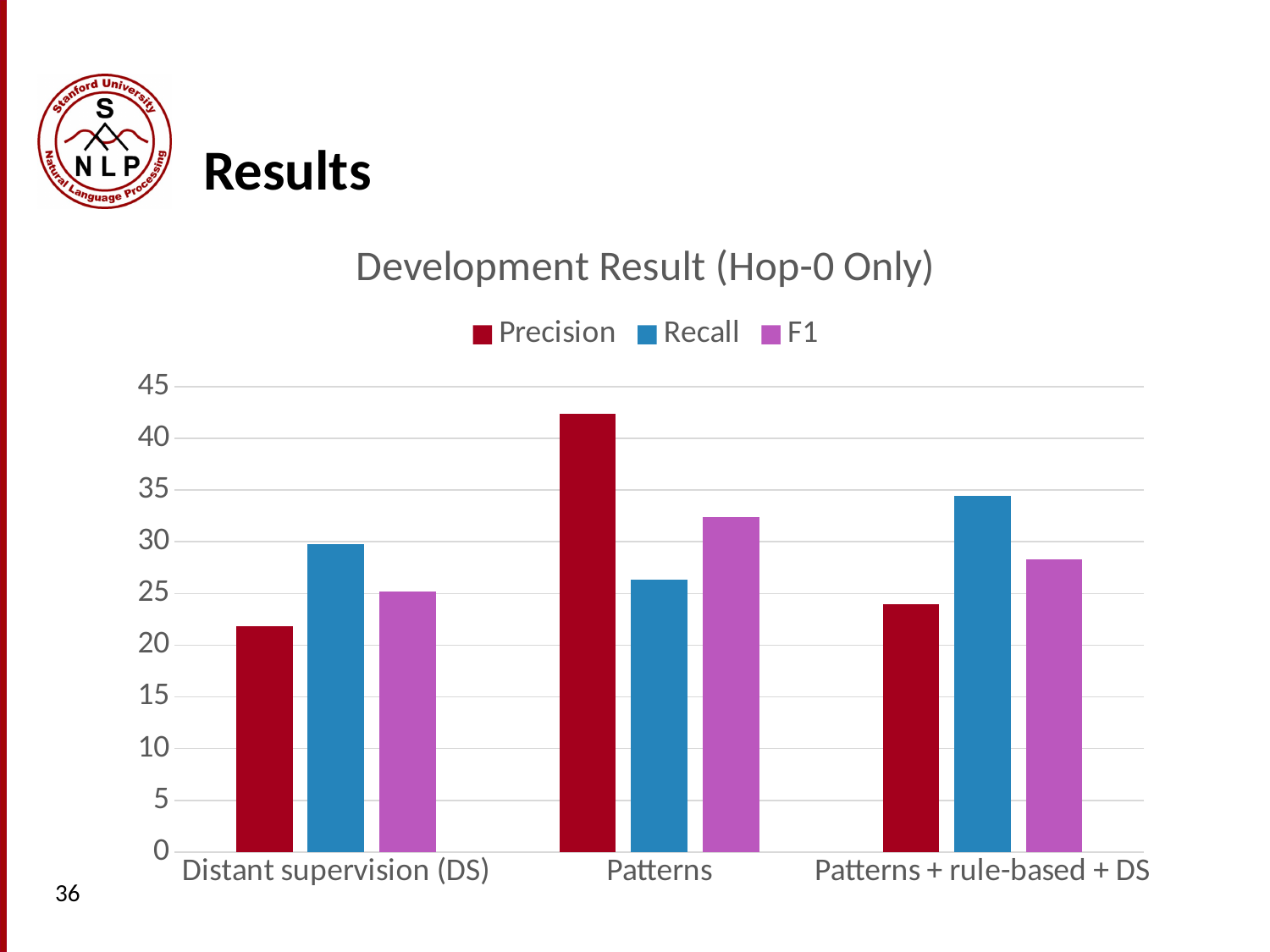
Is the F1 value for Patterns greater or less than 30? greater For the Patterns category, which is larger: Recall or F1? F1 Which has the larger Precision: Distant supervision (DS) or Patterns + rule-based + DS? Patterns + rule-based + DS Is the Precision value for Patterns greater or less than 40? greater What kind of chart is shown on the slide? bar chart How many series does the legend list? 3 Which category has the highest Recall? Patterns + rule-based + DS Which category has the highest Precision? Patterns How many categories are shown on the x axis? 3 Which category has the lowest Precision? Distant supervision (DS) What is the title of the chart? Development Result (Hop-0 Only) Is the Precision value for Distant supervision (DS) greater or less than 25? less